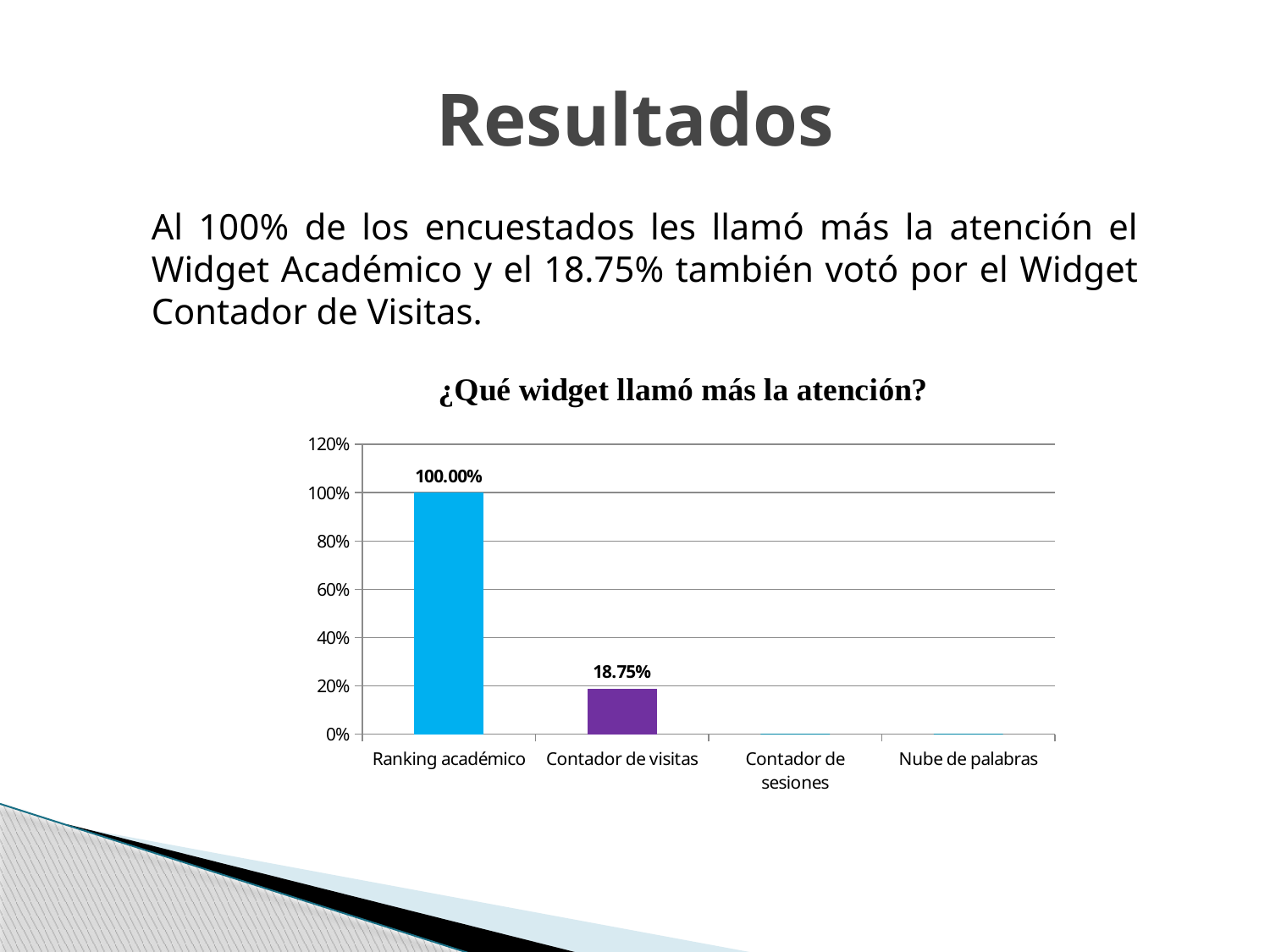
How many categories are shown on the x axis? 4 What is the difference between the values for Ranking académico and Contador de visitas? 81.25% What kind of chart is shown on the slide? bar chart What is the value for Ranking académico? 100.00% What is the value for Contador de visitas? 18.75% What is the highest value shown on the y axis? 120% Which category has the highest value? Ranking académico Which is larger, the value for Ranking académico or the value for Contador de visitas? Ranking académico What is the title of the chart? ¿Qué widget llamó más la atención? Is the value for Ranking académico greater or less than 80%? greater Is the value for Contador de visitas greater or less than 40%? less What colour is the bar for Contador de visitas? purple